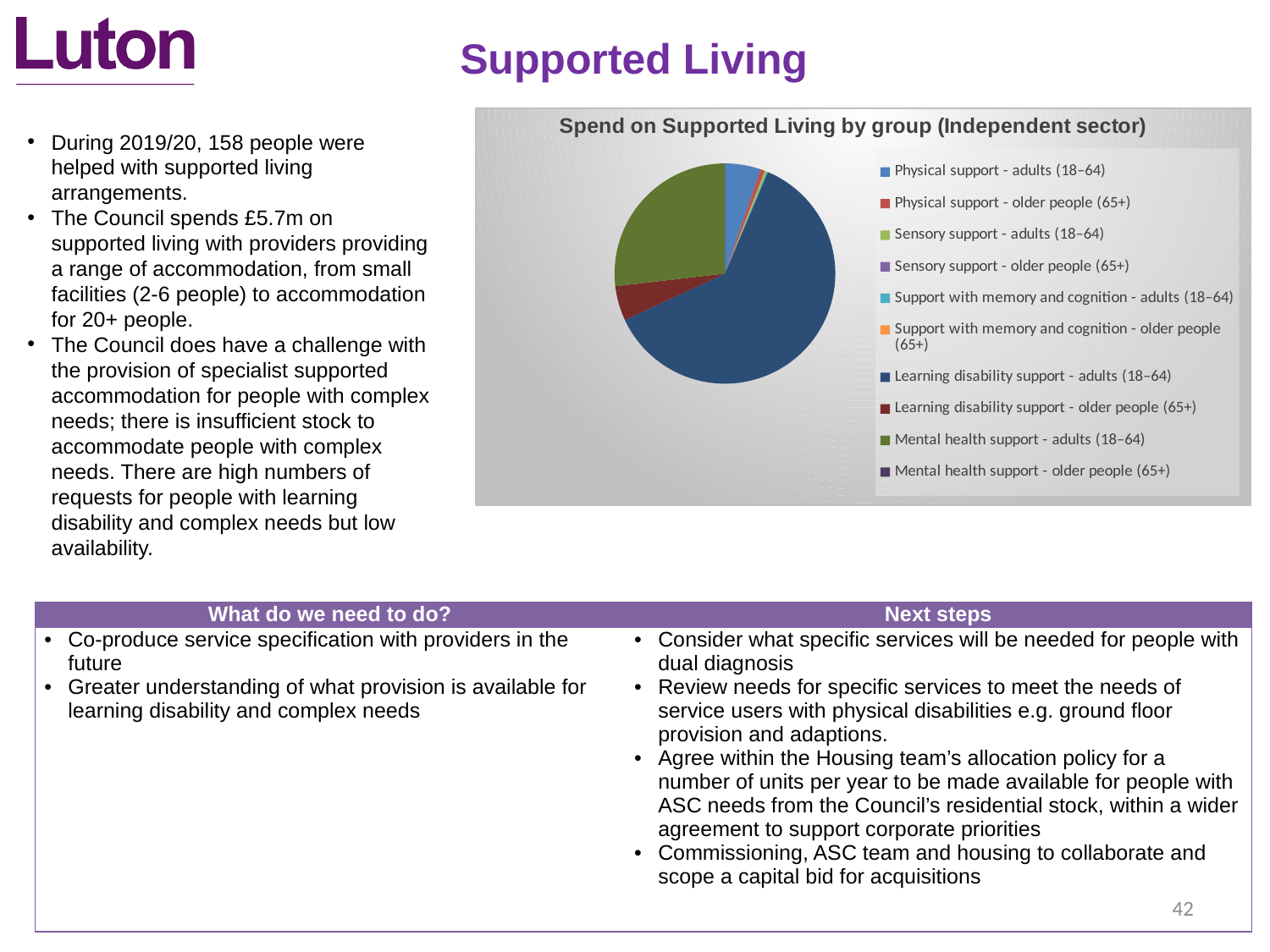
What is the title of the chart? Spend on Supported Living by group (Independent sector) How many entries does the chart's legend list? 10 What kind of chart is shown on the slide? Pie chart Which group accounts for the largest share of spend on supported living? Learning disability support - adults (18–64) Which is larger: the slice for Learning disability support - adults (18–64) or the slice for Mental health support - adults (18–64)? Learning disability support - adults (18–64) Which is larger: the slice for Mental health support - adults (18–64) or the slice for Learning disability support - older people (65+)? Mental health support - adults (18–64) Which group has the second-largest slice of the pie? Mental health support - adults (18–64)